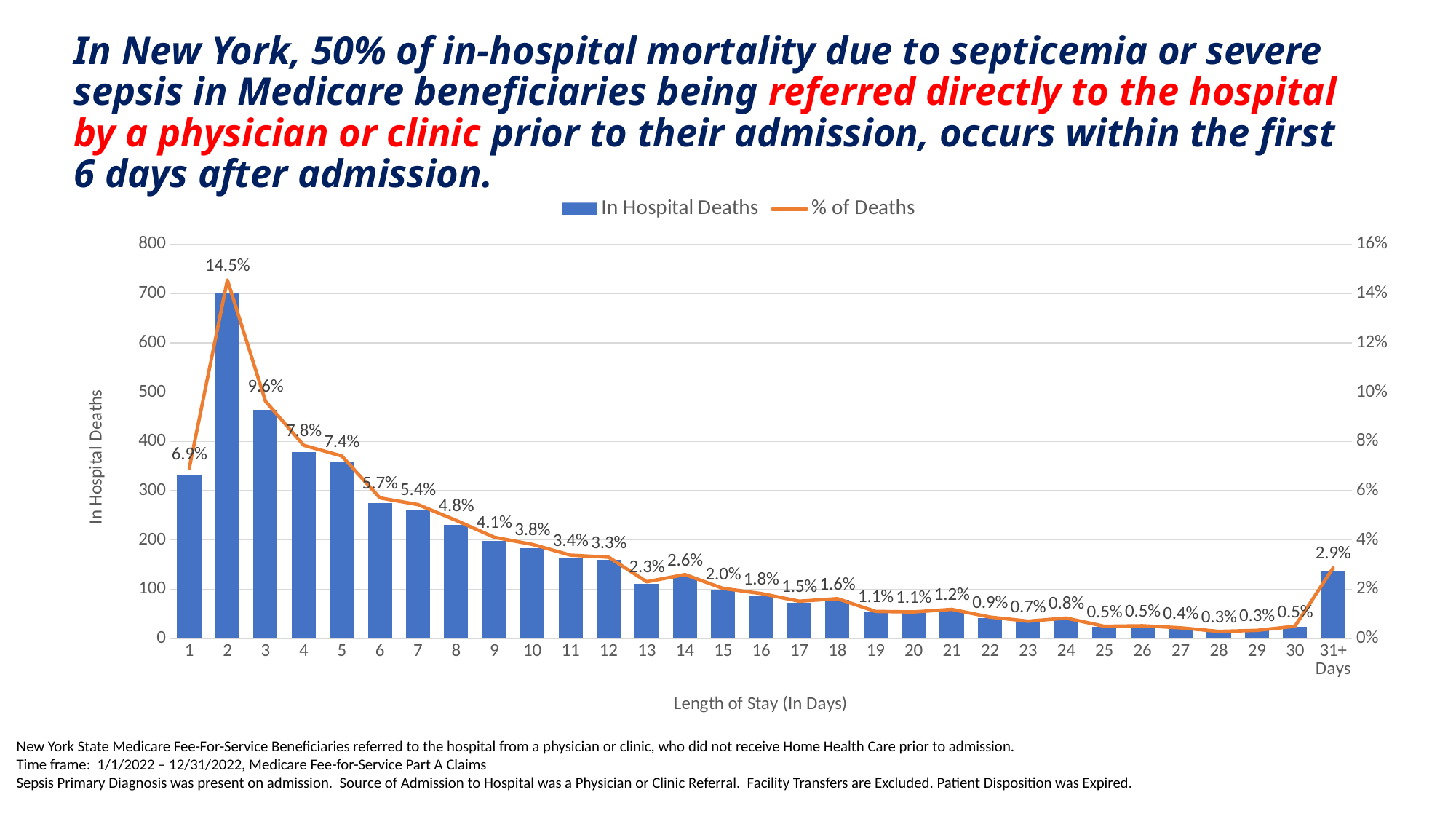
What is the % of Deaths value for a length of stay of 2 days? 14.5% How many length-of-stay categories are shown on the x axis? 31 What is the % of Deaths value for the 31+ Days category? 2.9% Do the % of Deaths values rise or fall from a length of stay of 2 days to 12 days? fall What is the % of Deaths value for a length of stay of 8 days? 4.8% Which has a larger % of Deaths, a length of stay of 13 days or 14 days? 14 days What is the difference in % of Deaths between a length of stay of 2 days and 3 days? 4.9% Is the In Hospital Deaths value for a length of stay of 6 days greater or less than 300? less How many series does the legend list? 2 Which length of stay has the highest % of Deaths? 2 What kind of chart is shown on the slide? A combined bar and line chart Is the In Hospital Deaths value for a length of stay of 2 days greater or less than 600? greater